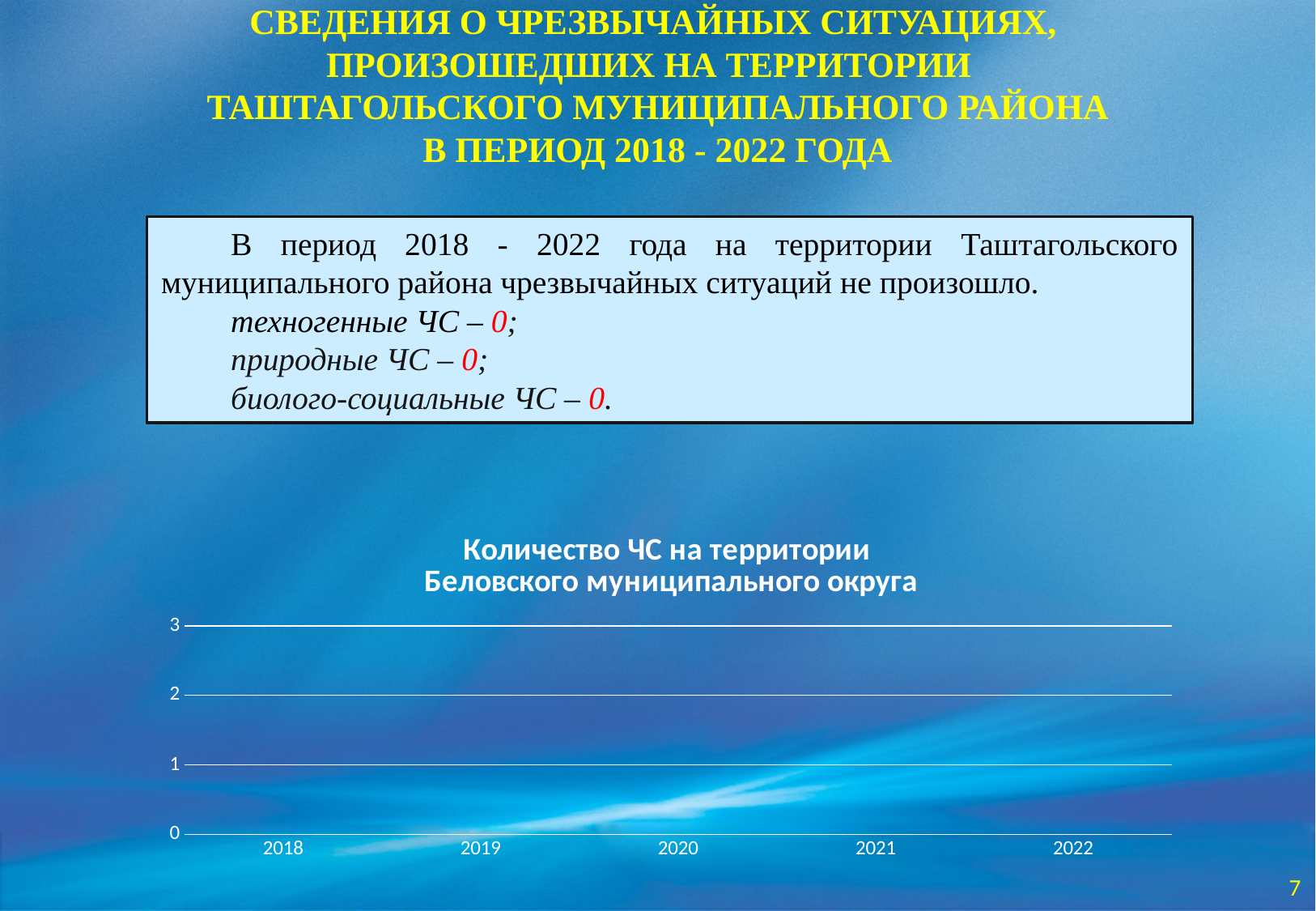
Is the value for 2022 greater or less than 2? less Is the value for 2018 greater or less than 1? less What is the last year shown on the x axis of the chart? 2022 What is the first year shown on the x axis of the chart? 2018 What is the highest tick value shown on the y axis of the chart? 3 What is the title of the chart? Количество ЧС на территории Беловского муниципального округа How many categories are shown on the x axis of the chart? 5 Is the value for 2020 greater or less than 1? less